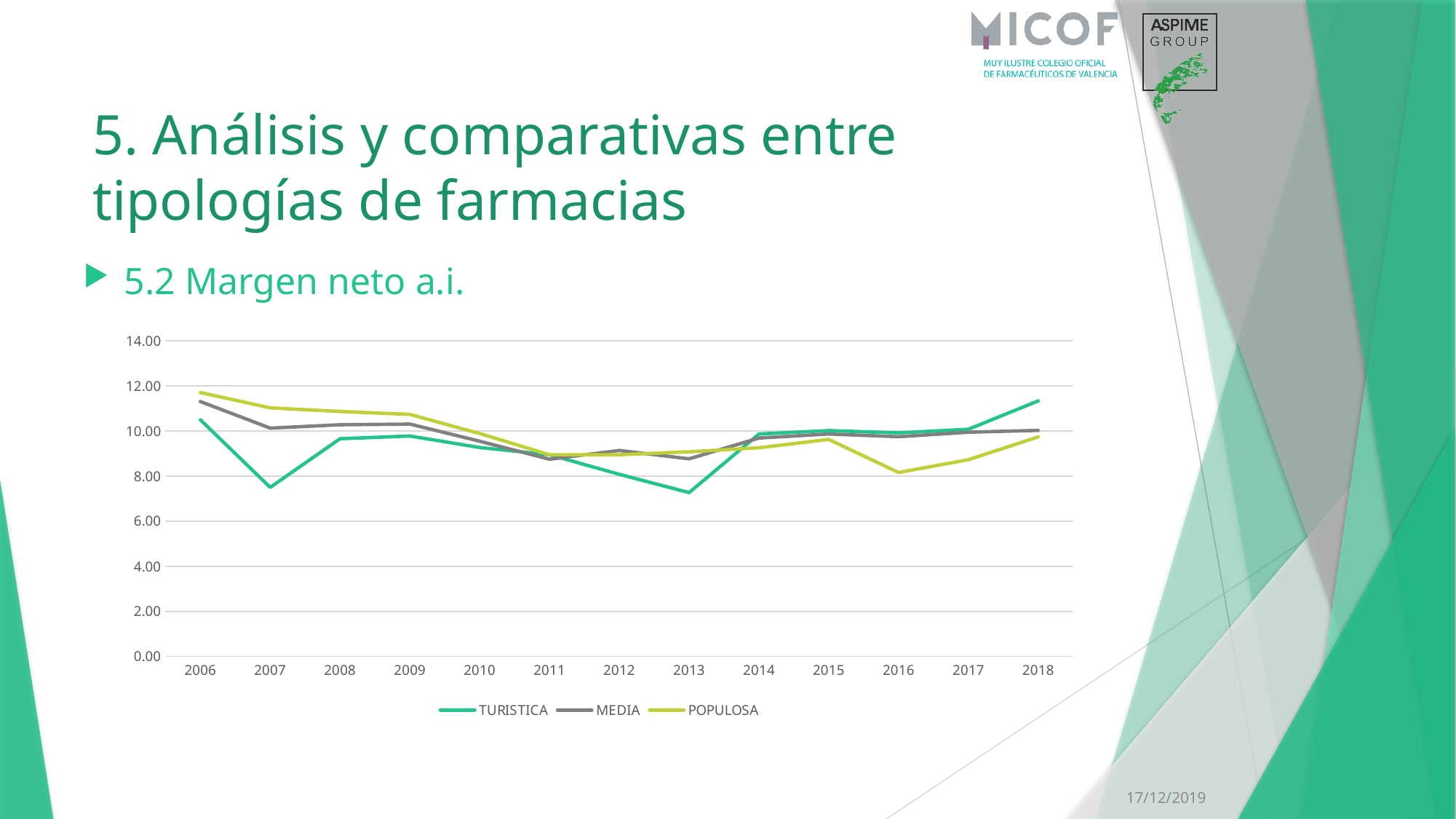
How many years are shown on the x axis? 13 Is the value for POPULOSA in 2016 greater or less than 10.00? less Is the value for TURISTICA in 2018 greater or less than 10.00? greater Is the value for TURISTICA in 2007 greater or less than 8.00? less Which series has the highest value in 2006? POPULOSA In 2013, which is larger: the value for POPULOSA or the value for TURISTICA? POPULOSA Does the TURISTICA series rise or fall from 2013 to 2018? rise How many series does the legend list? 3 What kind of chart is shown on the slide? line chart In which year does the TURISTICA series reach its highest value? 2018 Which series has the lowest value in 2016? POPULOSA